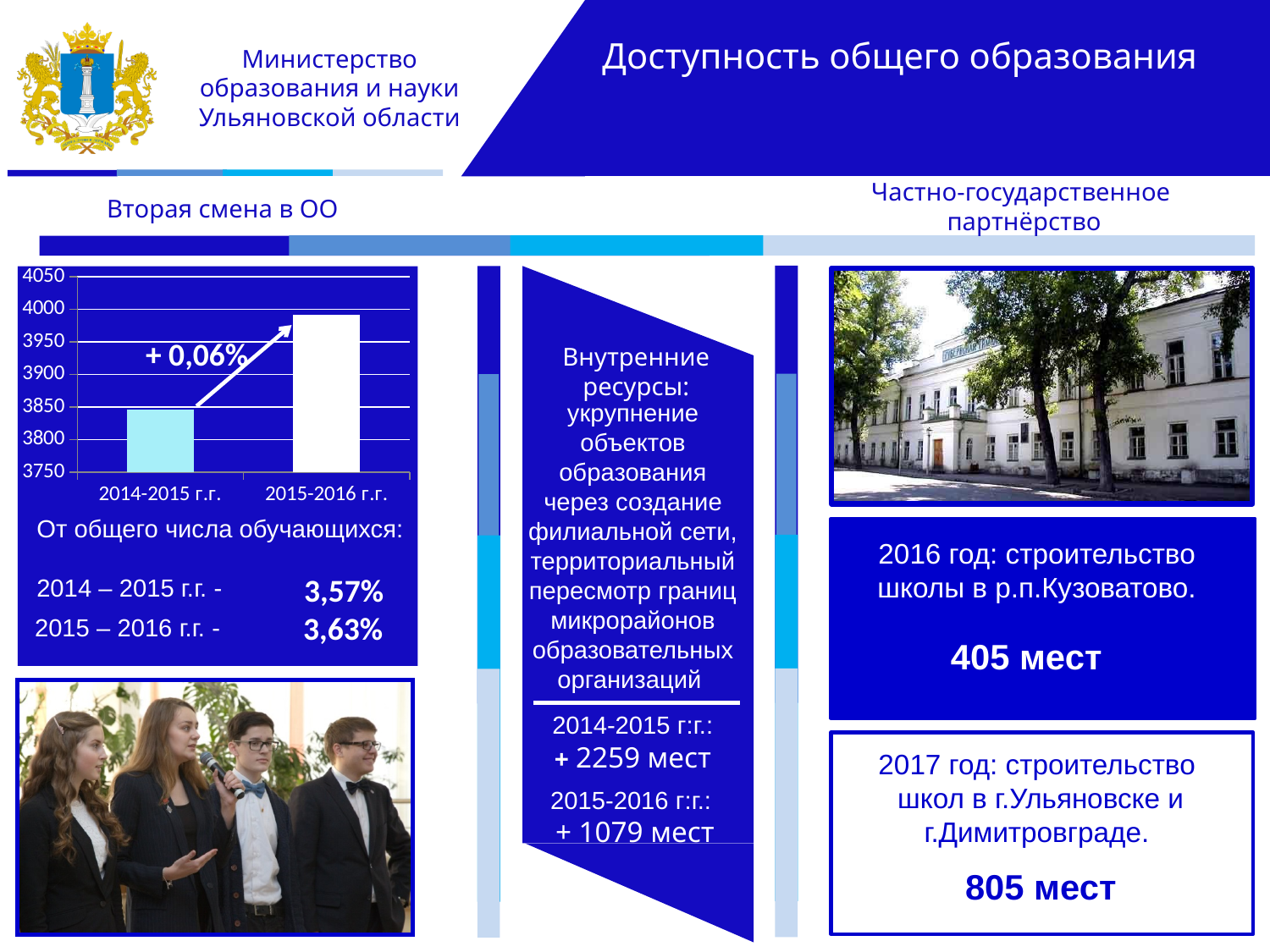
Which bar is taller, 2014-2015 г.г. or 2015-2016 г.г.? 2015-2016 г.г. Which category has the lowest bar in the chart? 2014-2015 г.г. Do the values rise or fall from 2014-2015 г.г. to 2015-2016 г.г.? rise What kind of chart is shown under the heading "Вторая смена в ОО"? bar chart Is the value for 2014-2015 г.г. greater or less than 3900? less What is the lowest value shown on the chart's y axis? 3750 What percentage change is annotated next to the arrow on the chart? + 0,06% Which category has the highest bar in the chart? 2015-2016 г.г. How many categories are plotted on the x axis of the bar chart? 2 Is the value for 2015-2016 г.г. greater or less than 3950? greater Is the value for 2014-2015 г.г. greater or less than 3800? greater